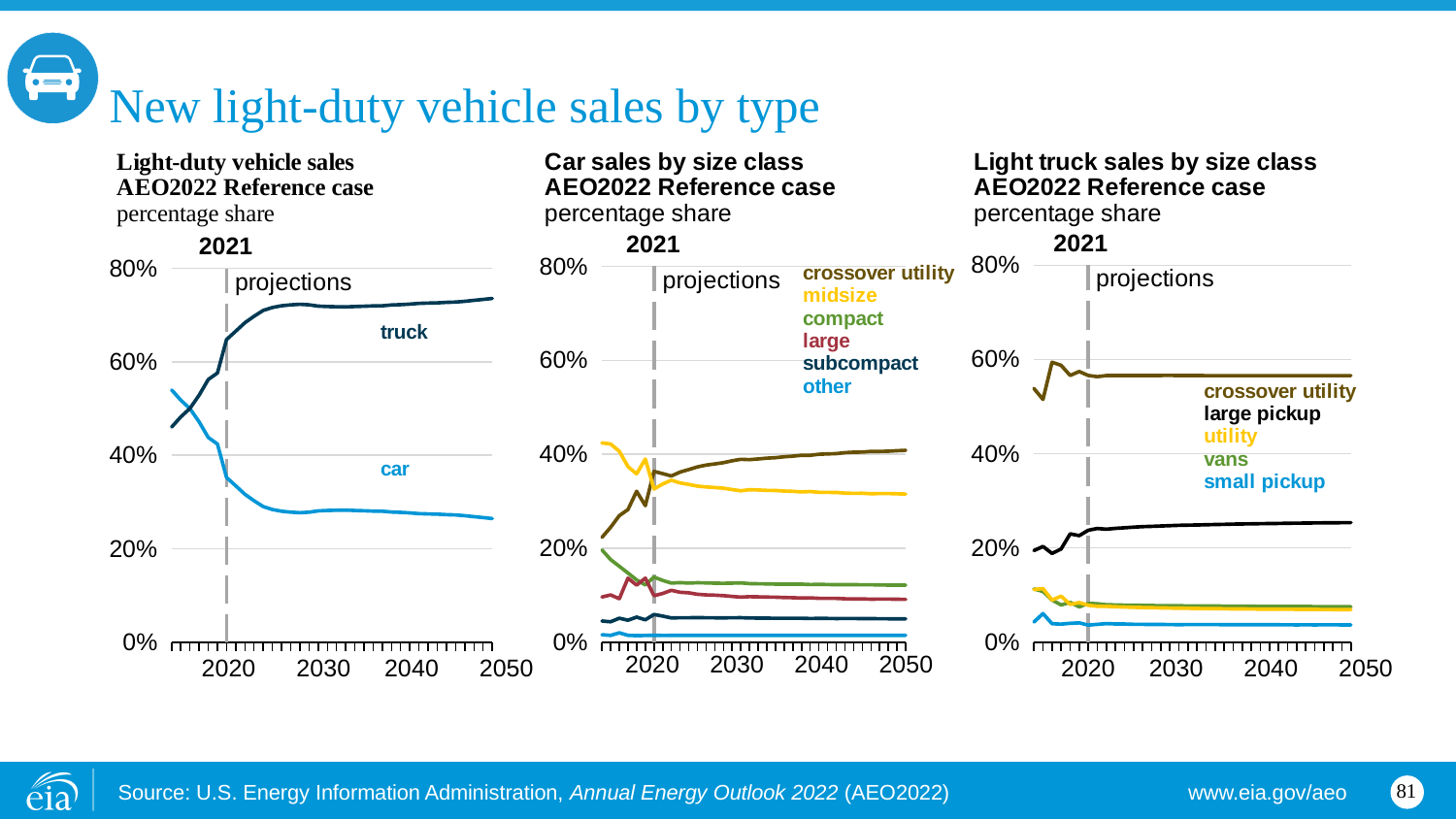
In the 'Light truck sales by size class' chart, which size class has the lowest share in 2050? small pickup What year does the vertical dashed line in each chart mark as the start of projections? 2021 In the 'Light-duty vehicle sales' chart, which is larger in 2050, the truck share or the car share? truck In the 'Car sales by size class' chart, how many size classes are listed in the legend? 6 In the 'Car sales by size class' chart, is the midsize share in 2050 greater or less than 40%? less In the 'Light-duty vehicle sales' chart, how many series are plotted? 2 In the 'Light-duty vehicle sales' chart, does the truck share rise or fall over the projection period? rise What kind of chart is the 'Light-duty vehicle sales' chart on the left? line chart In the 'Car sales by size class' chart, which size class has the highest share in 2050? crossover utility In the 'Light-duty vehicle sales' chart, is the truck share in 2050 greater or less than 60%? greater How many charts are shown on the slide? 3 In the 'Light truck sales by size class' chart, is the large pickup share in 2050 greater or less than 20%? greater